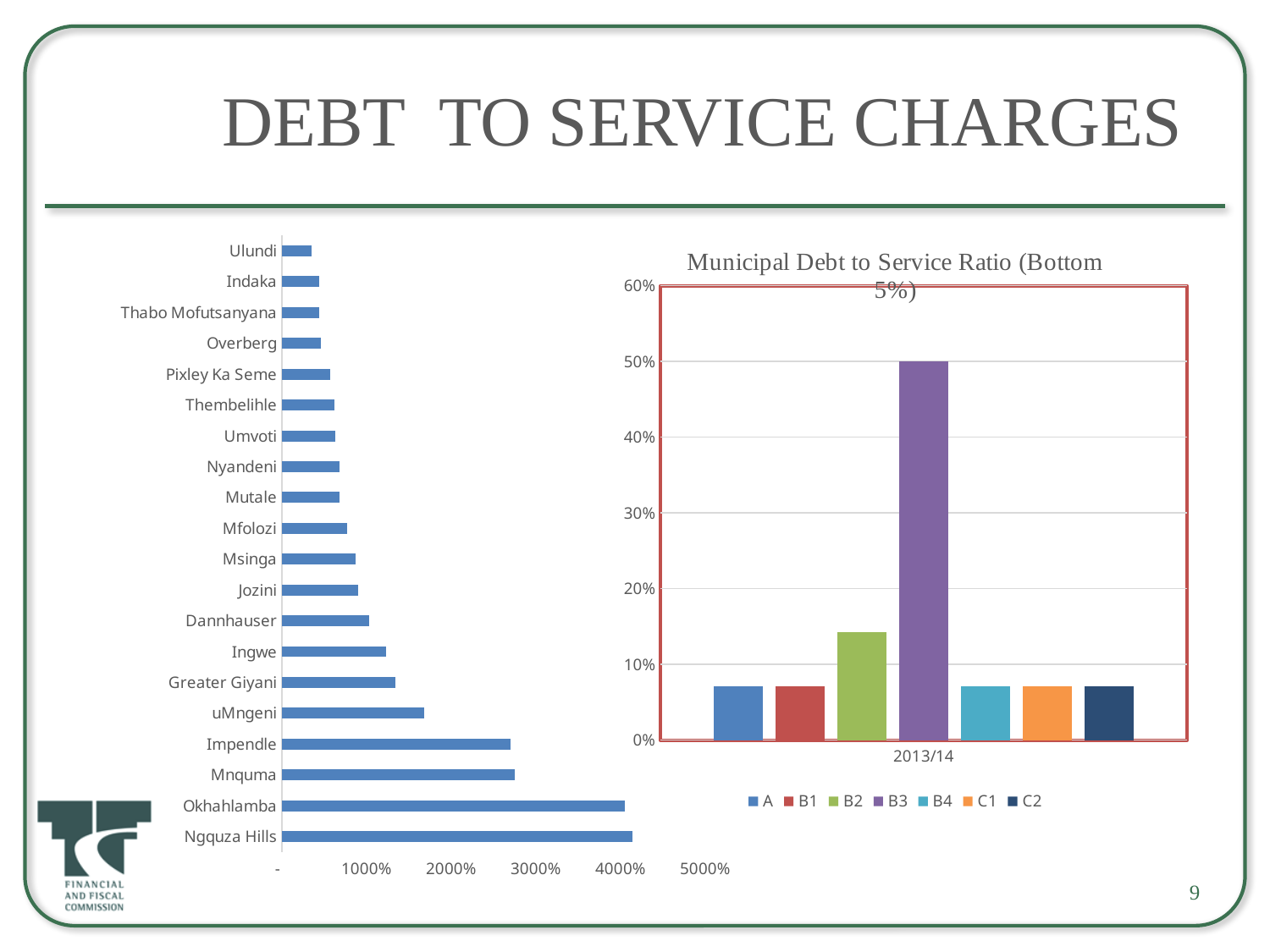
In the 'Municipal Debt to Service Ratio (Bottom 5%)' chart, which series has the highest value? B3 What kind of chart is the chart on the left of the slide? bar chart In the chart on the left of the slide, is the value for uMngeni greater or less than 2000%? less In the 'Municipal Debt to Service Ratio (Bottom 5%)' chart, is the value for B3 greater or less than 40%? greater How many municipalities are listed in the chart on the left of the slide? 20 In the chart on the left of the slide, is the value for Impendle greater or less than 2000%? greater In the chart on the left of the slide, which municipality has the lowest value? Ulundi In the chart on the left of the slide, which has the larger value, Mnquma or Greater Giyani? Mnquma How many series does the legend of the 'Municipal Debt to Service Ratio (Bottom 5%)' chart list? 7 In the chart on the left of the slide, which municipality has the highest value? Ngquza Hills In the 'Municipal Debt to Service Ratio (Bottom 5%)' chart, which has the larger value, B2 or A? B2 What is the title of the chart on the right of the slide? Municipal Debt to Service Ratio (Bottom 5%)